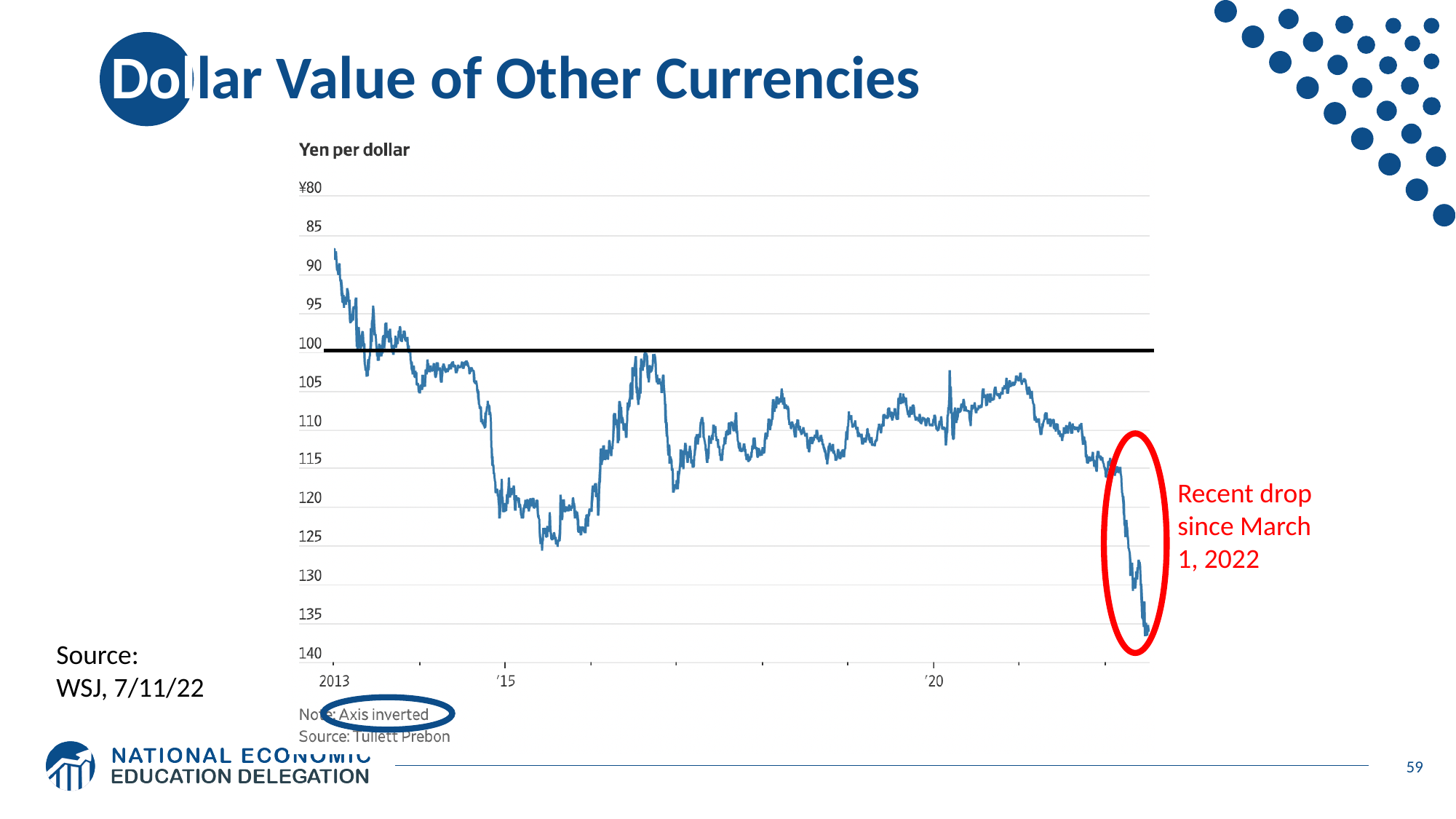
Does the yen per dollar value rise or fall from the start of 2013 to the end of the line in 2022? rise Is the yen per dollar value at the end of the line (mid-2022) greater or less than 130? greater Which is larger, the yen per dollar value at the start of 2013 or at the end of the line in 2022? end of the line in 2022 Is the yen per dollar value at the start of 2013 greater or less than 100? less How many year labels are printed on the x axis? 3 Is the yen per dollar value at the '20 tick mark greater or less than 100? greater What does the note below the chart say about the axis? Axis inverted What kind of chart is shown on the slide? line chart How many data series are plotted in the chart? 1 What is the title printed above the chart's y axis? Yen per dollar Does the yen per dollar value rise or fall between March 2022 and the end of the line? rise